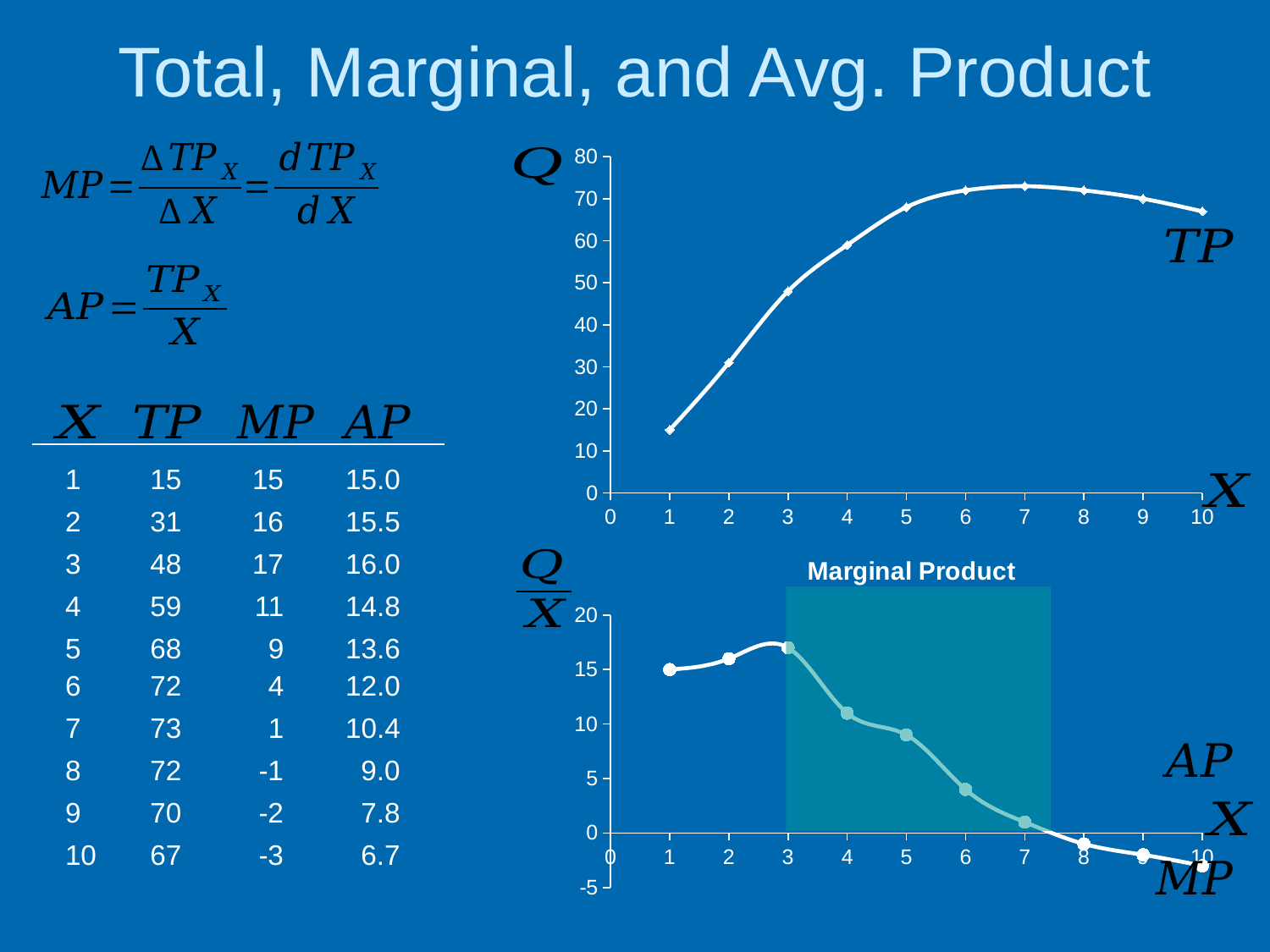
What is the title of the bottom chart? Marginal Product In the top chart (TP), is the value of TP at X = 1 greater or less than 20? less In the bottom chart (Marginal Product), does the marginal product rise or fall between X = 3 and X = 10? fall In the top chart (TP), does TP rise or fall between X = 1 and X = 5? rise In the bottom chart (Marginal Product), at which value of X is the marginal product highest? 3 In the top chart (TP), how many data points are plotted? 10 In the bottom chart (Marginal Product), is the value at X = 6 greater or less than 5? less In the top chart (TP), at which value of X does TP reach its highest point? 7 In the bottom chart (Marginal Product), at which value of X is the marginal product lowest? 10 In the top chart (TP), at which value of X is TP lowest? 1 What type of chart is the top chart on the slide? line chart In the top chart (TP), is the value of TP at X = 3 greater or less than 40? greater